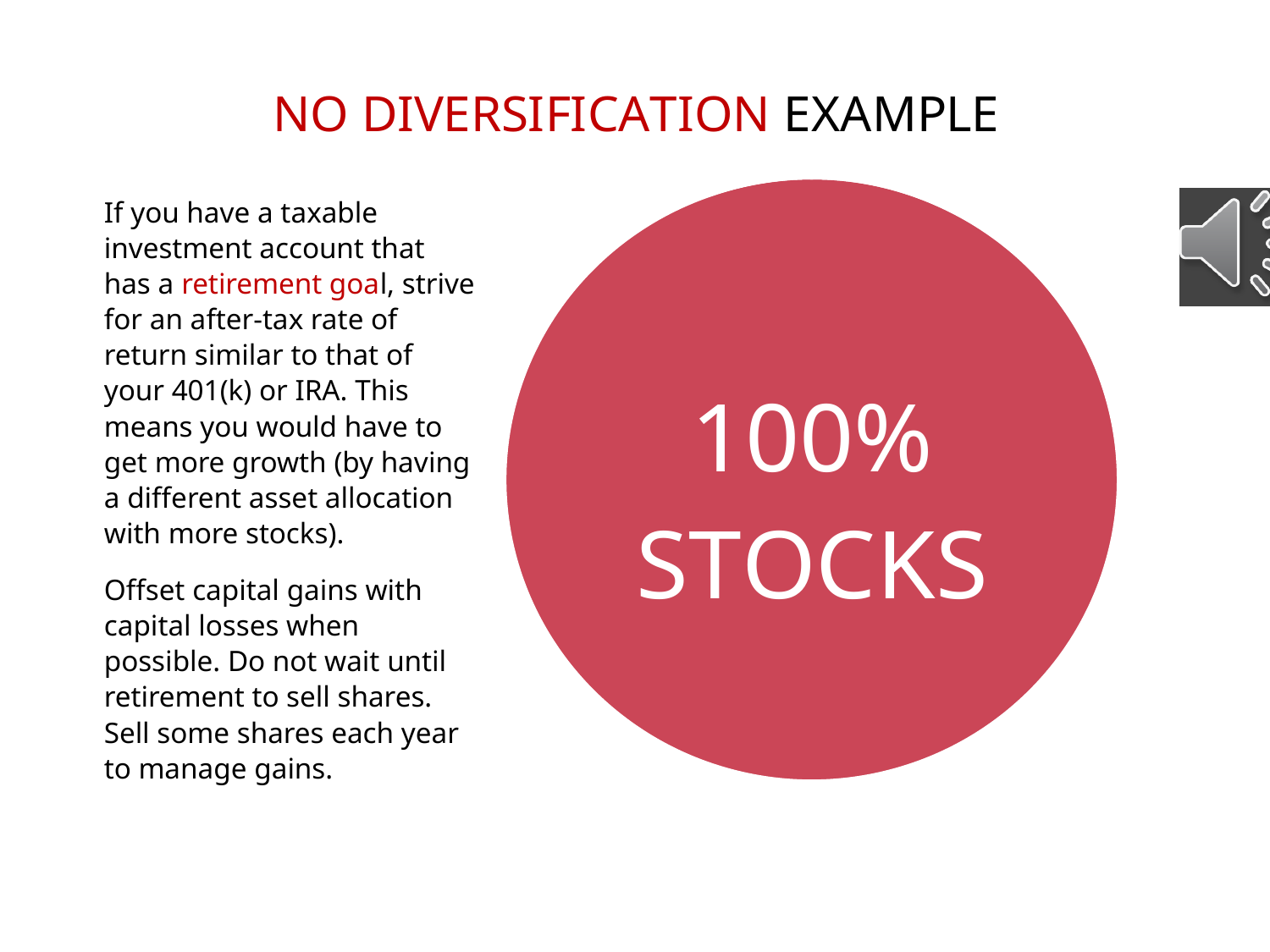
What share of the pie chart is labelled STOCKS? 100% Which asset class makes up the entire pie chart? STOCKS What is the title of the slide containing the pie chart? NO DIVERSIFICATION EXAMPLE What colour is the pie chart? red Is the share for STOCKS greater or less than 50%? greater How many categories does the pie chart show? 1 What value is printed on the pie chart? 100% What kind of chart is shown on the slide? pie chart